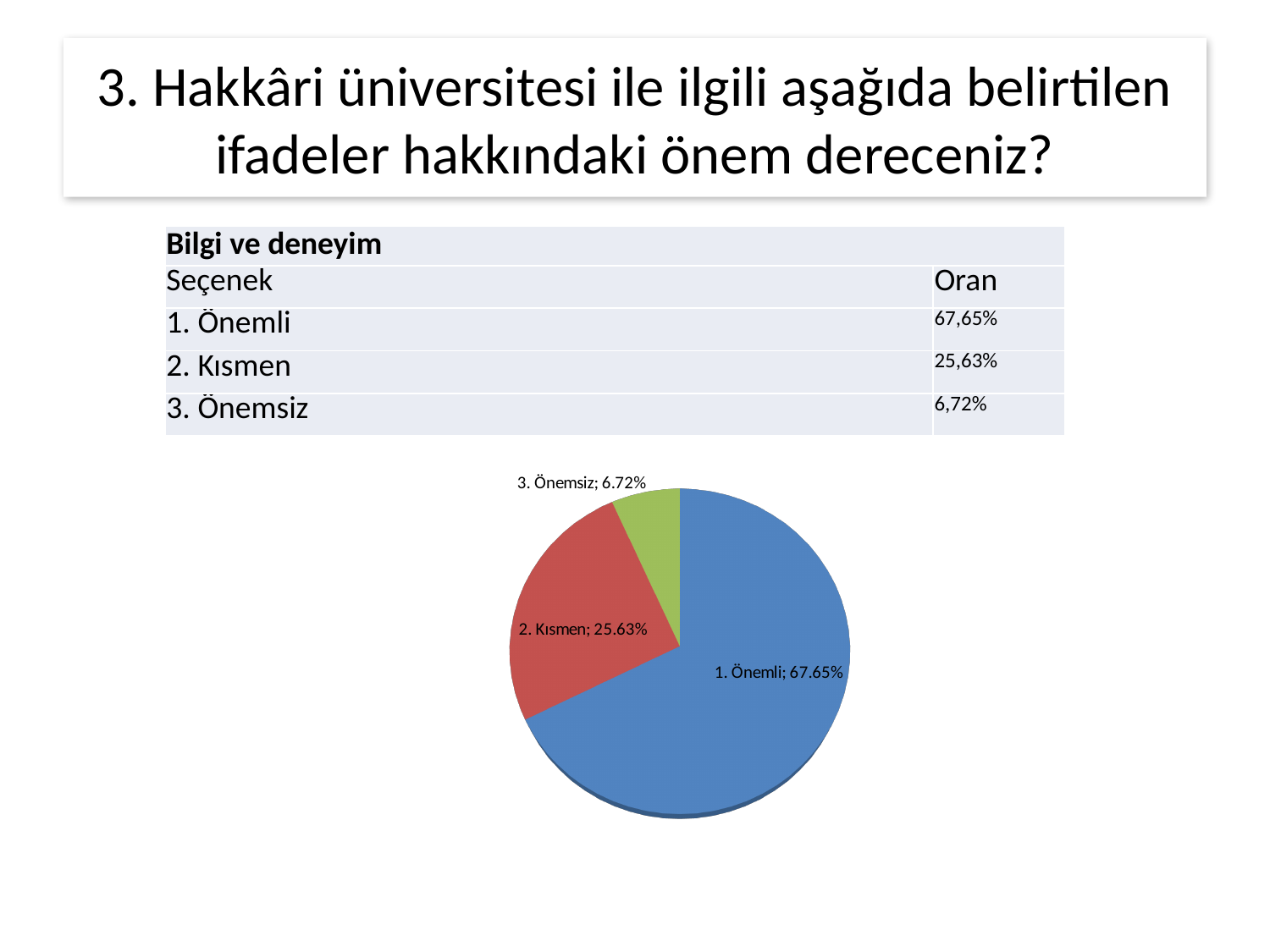
How many slices does the pie chart have? 3 Which slice of the pie chart is the largest? 1. Önemli What share of the pie does the "1. Önemli" slice represent? 67.65% In the pie chart, which is larger: the slice for "2. Kısmen" or the slice for "3. Önemsiz"? 2. Kısmen What is the value shown for the slice labelled "2. Kısmen" in the pie chart? 25.63% What is the difference in percentage points between the "1. Önemli" slice and the "2. Kısmen" slice in the pie chart? 42.02 What is the value shown for the slice labelled "1. Önemli" in the pie chart? 67.65% What is the difference in percentage points between the "2. Kısmen" slice and the "3. Önemsiz" slice in the pie chart? 18.91 What is the value shown for the slice labelled "3. Önemsiz" in the pie chart? 6.72% What colour is the "2. Kısmen" slice in the pie chart? red Which slice of the pie chart is the smallest? 3. Önemsiz What kind of chart is shown on the slide? pie chart